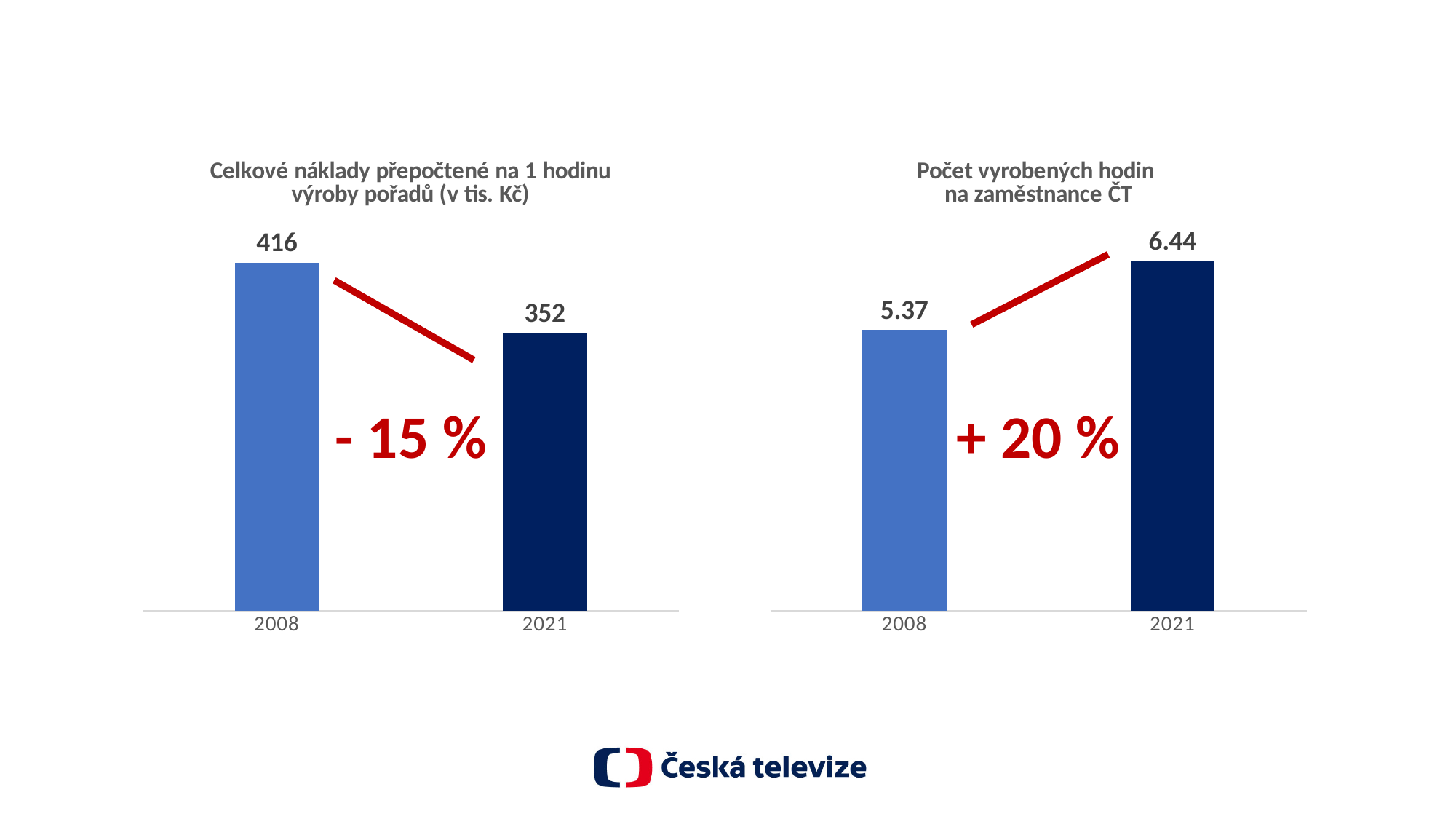
In the right chart, what is the difference between the 2021 and 2008 values? 1.07 In the right chart, is the value for 2021 larger or smaller than the value for 2008? larger How many bars does the left chart show? 2 In the left chart (Celkové náklady přepočtené na 1 hodinu výroby pořadů), what is the value for 2008? 416 In the right chart, which year has the lower value? 2008 What type of chart is the right chart? bar chart In the left chart, which year has the higher value? 2008 In the right chart (Počet vyrobených hodin na zaměstnance ČT), what is the value for 2021? 6.44 In the left chart, what is the difference between the 2008 and 2021 values? 64 In the left chart, do the values rise or fall from 2008 to 2021? fall In the right chart (Počet vyrobených hodin na zaměstnance ČT), what is the value for 2008? 5.37 In the left chart (Celkové náklady přepočtené na 1 hodinu výroby pořadů), what is the value for 2021? 352